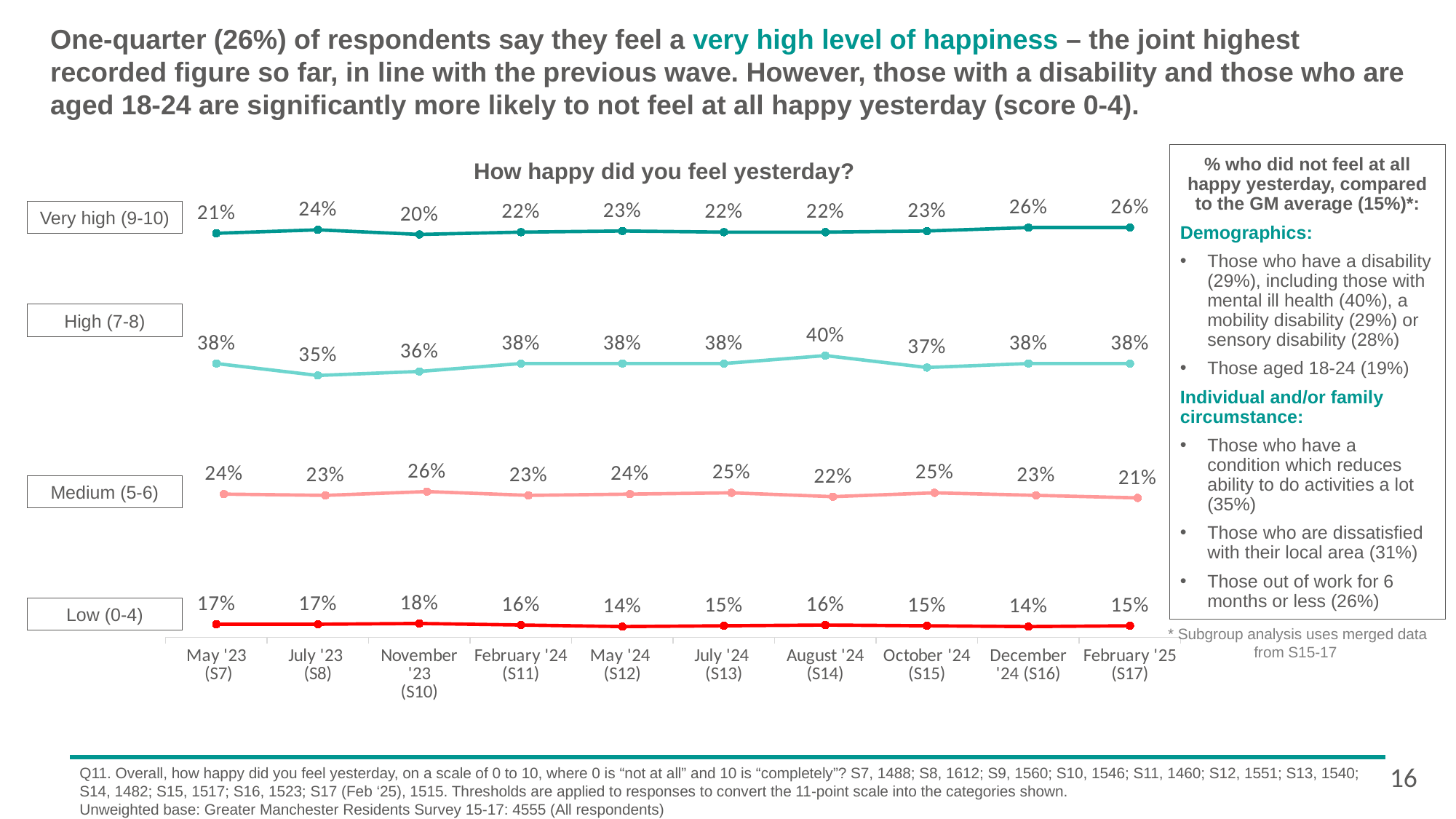
What is the title of the chart? How happy did you feel yesterday? In July '23 (S8), which was larger: Medium (5-6) or Low (0-4)? Medium (5-6) What percentage of respondents were in the Low (0-4) category in May '24 (S12)? 14% What percentage of respondents reported a very high level of happiness (9-10) in February '25 (S17)? 26% Does the Very high (9-10) series rise or fall between May '23 (S7) and February '25 (S17)? Rises In which wave did the High (7-8) series reach its highest value? August '24 (S14) How many survey waves are plotted along the x axis? 10 What was the value for High (7-8) in August '24 (S14)? 40% In which wave was the Very high (9-10) value lowest? November '23 (S10) How many happiness categories (series) are plotted in the chart? 4 In February '25 (S17), how many percentage points higher is High (7-8) than Very high (9-10)? 12 percentage points What type of chart is used to show how happy respondents felt yesterday? Line chart